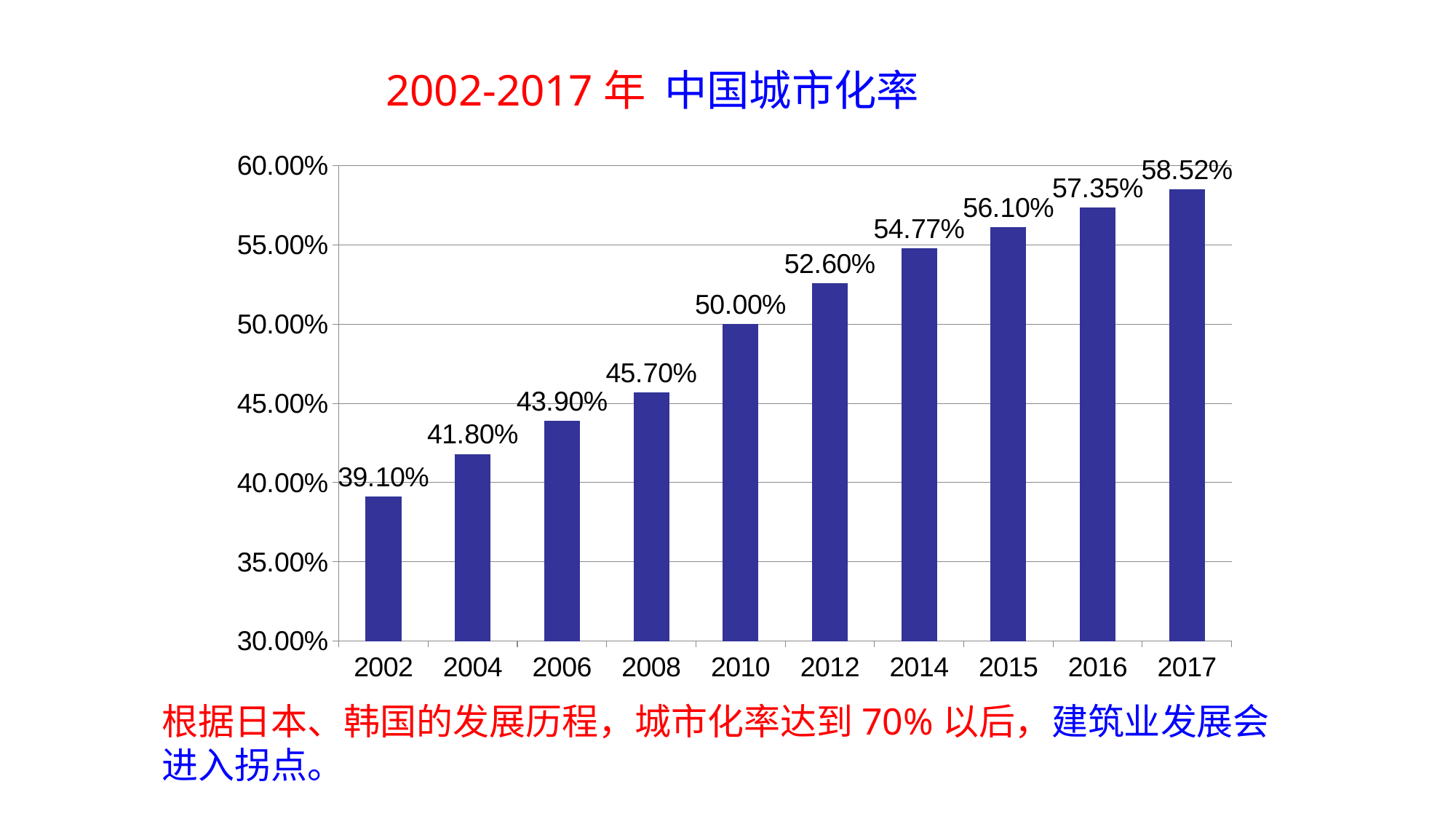
What is the difference between the values for 2017 and 2002? 19.42% What is the value shown for 2015? 56.10% What is the value shown for 2002? 39.10% Which year has the highest value? 2017 What kind of chart is shown on the slide? bar chart Is the value for 2014 greater or less than 55.00%? less How many years are shown on the x axis? 10 What is the urbanization rate shown for 2010? 50.00% Which year has the lowest value? 2002 What is the difference between the values for 2012 and 2010? 2.60% Which is larger, the value for 2008 or the value for 2006? 2008 Do the values rise or fall from 2002 to 2017? rise